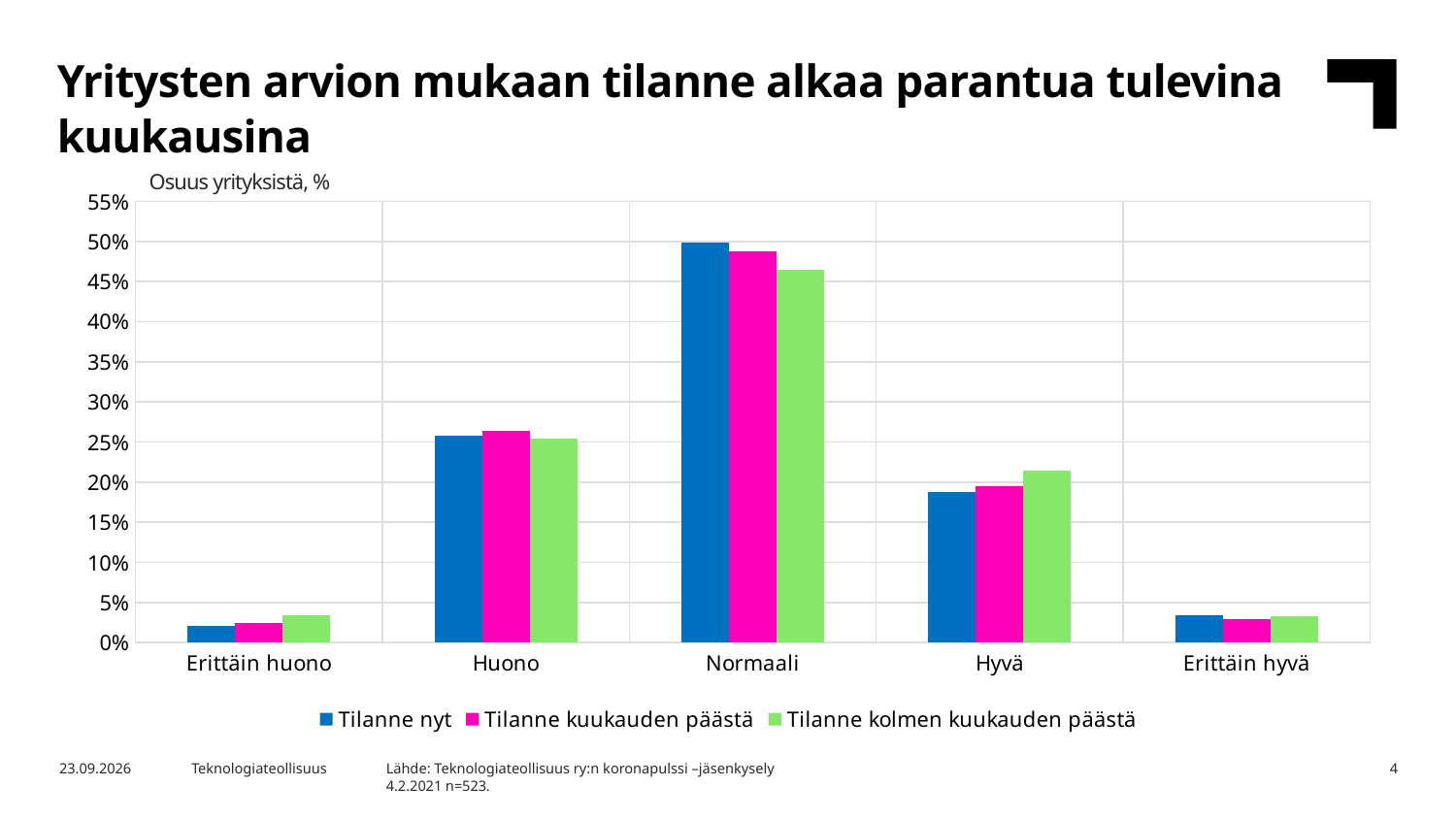
Is the value for "Hyvä" in the series "Tilanne kolmen kuukauden päästä" greater or less than 20%? greater What label is shown above the vertical axis of the chart? Osuus yrityksistä, % For the category "Normaali", which series has the larger value: "Tilanne nyt" or "Tilanne kolmen kuukauden päästä"? Tilanne nyt Is the value for "Erittäin huono" in the series "Tilanne nyt" greater or less than 5%? less Is the value for "Huono" in the series "Tilanne nyt" greater or less than 20%? greater Which category has the highest value for the series "Tilanne nyt"? Normaali What kind of chart is shown on the slide? bar chart How many categories are shown on the x axis of the chart? 5 How many series does the chart's legend list? 3 For the category "Hyvä", which series has the larger value: "Tilanne nyt" or "Tilanne kolmen kuukauden päästä"? Tilanne kolmen kuukauden päästä Which category has the lowest value for the series "Tilanne nyt"? Erittäin huono